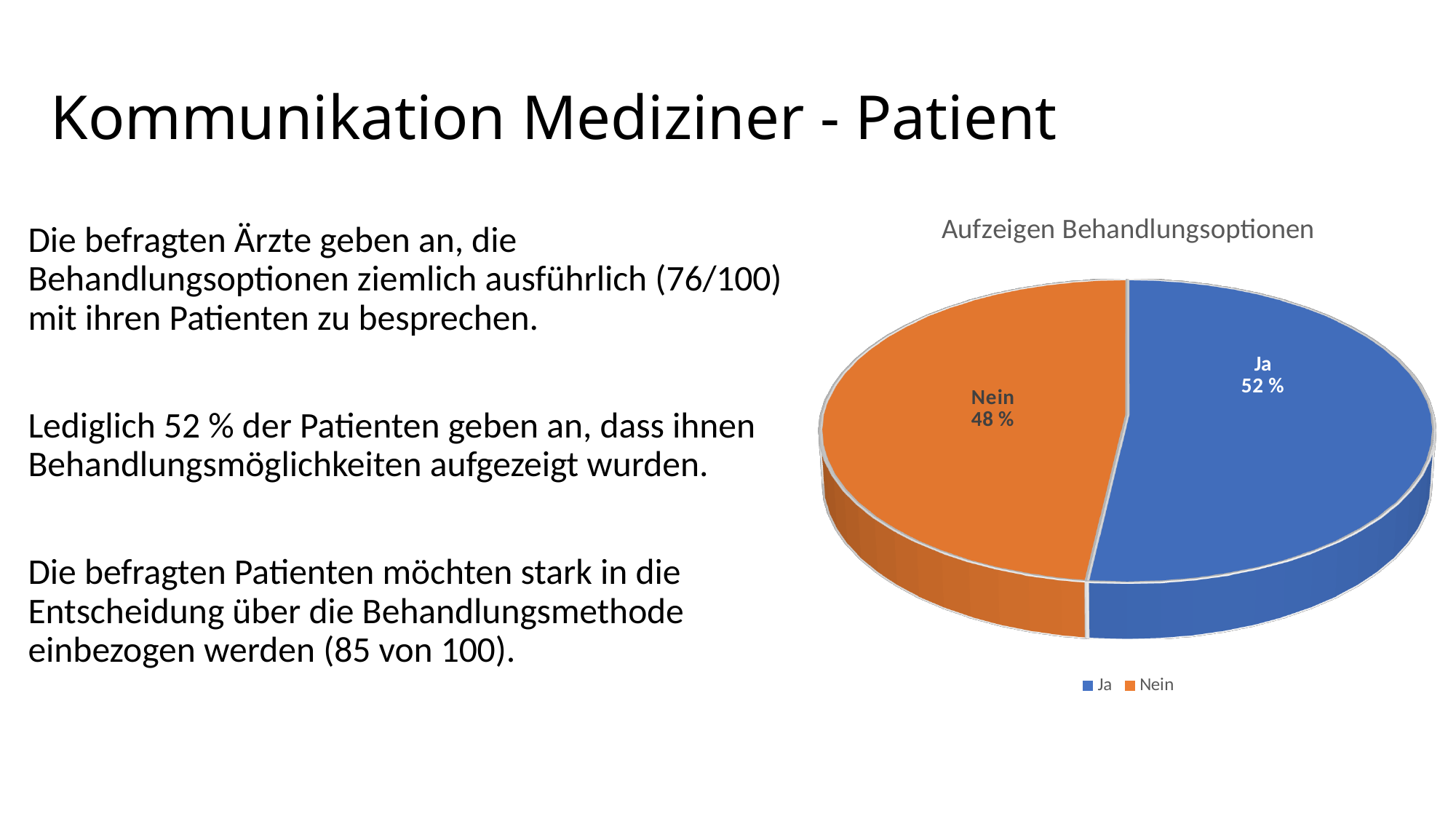
What is the difference in percentage points between the "Ja" and "Nein" slices? 4 % What colour is the "Nein" slice? Orange Which slice is the smallest in the pie chart? Nein What share of the pie does the "Ja" slice represent? 52 % Which slice is larger, "Ja" or "Nein"? Ja How many entries does the legend list? 2 What share of the pie does the "Nein" slice represent? 48 % How many slices does the pie chart have? 2 What is the title of the chart? Aufzeigen Behandlungsoptionen Which slice is the largest in the pie chart? Ja What type of chart is shown on the slide? Pie chart